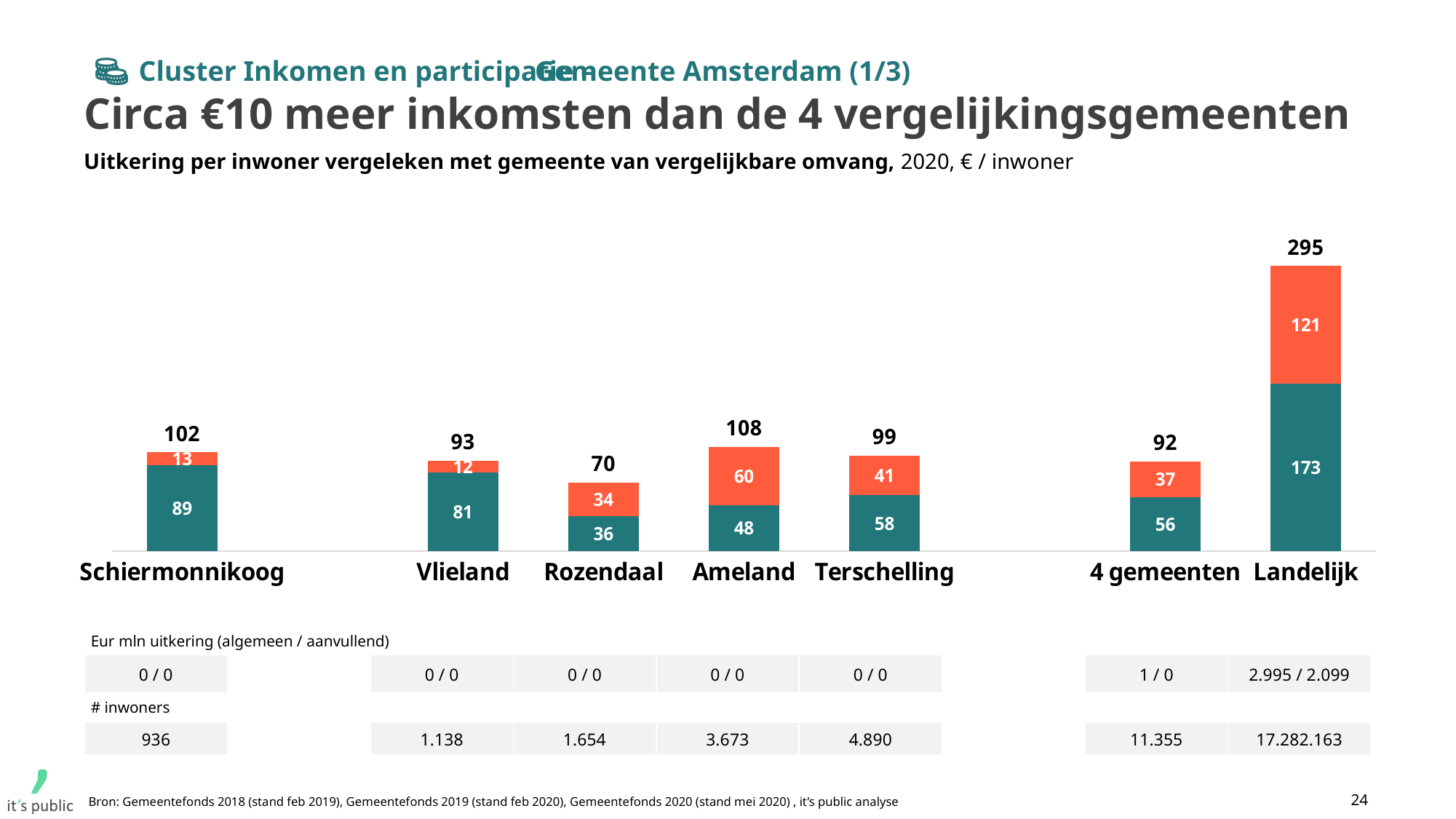
What is the total value of the stacked bar for Landelijk? 295 What is the difference between the orange segment for Terschelling and the orange segment for Vlieland? 29 What is the value of the teal (bottom) segment for 4 gemeenten? 56 What kind of chart is shown on the slide? Stacked bar chart What is the value of the teal (bottom) segment for Schiermonnikoog? 89 Which has a larger total, Ameland or Terschelling? Ameland What unit is stated in the chart subtitle for the values? € / inwoner Which category has the lowest total value? Rozendaal How many categories are shown on the x axis of the chart? 7 What is the value of the orange (top) segment for Ameland? 60 Which category has the highest total value? Landelijk What is the difference between the total for Landelijk and the total for 4 gemeenten? 203